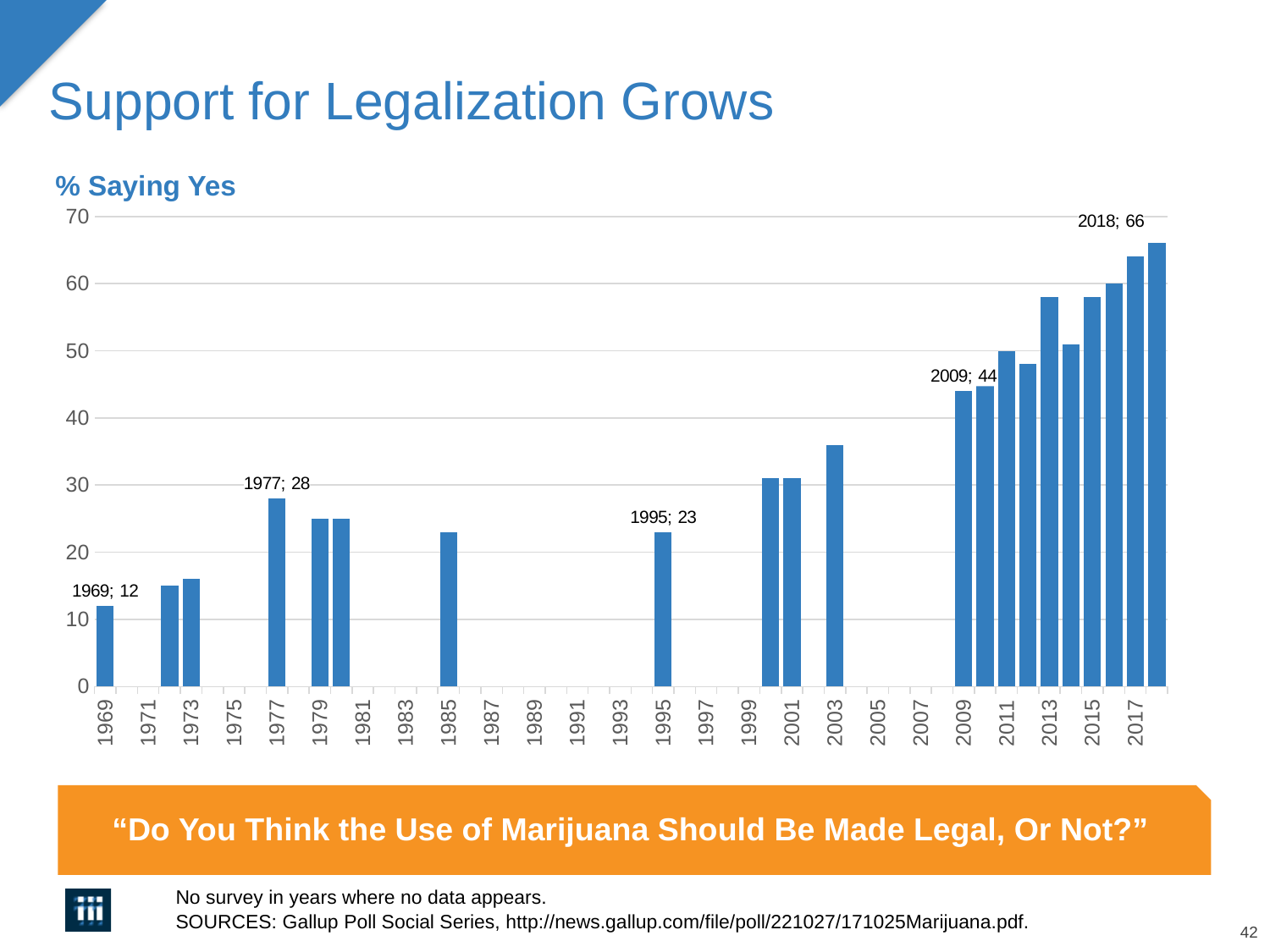
What percentage said yes in 1969? 12 What is the value shown for 2009? 44 By how many points did the value increase from 1969 to 2018? 54 What value is labeled for 1977? 28 What percentage said yes in 1995? 23 Which year has the lowest percentage saying yes? 1969 Do the values generally rise or fall from 1969 to 2018? rise Is the value for 2003 greater or less than 30? greater Which year has the larger value, 1977 or 1995? 1977 What kind of chart is shown on the slide? bar chart What is the value shown for 2018? 66 Which year has the highest percentage saying yes? 2018